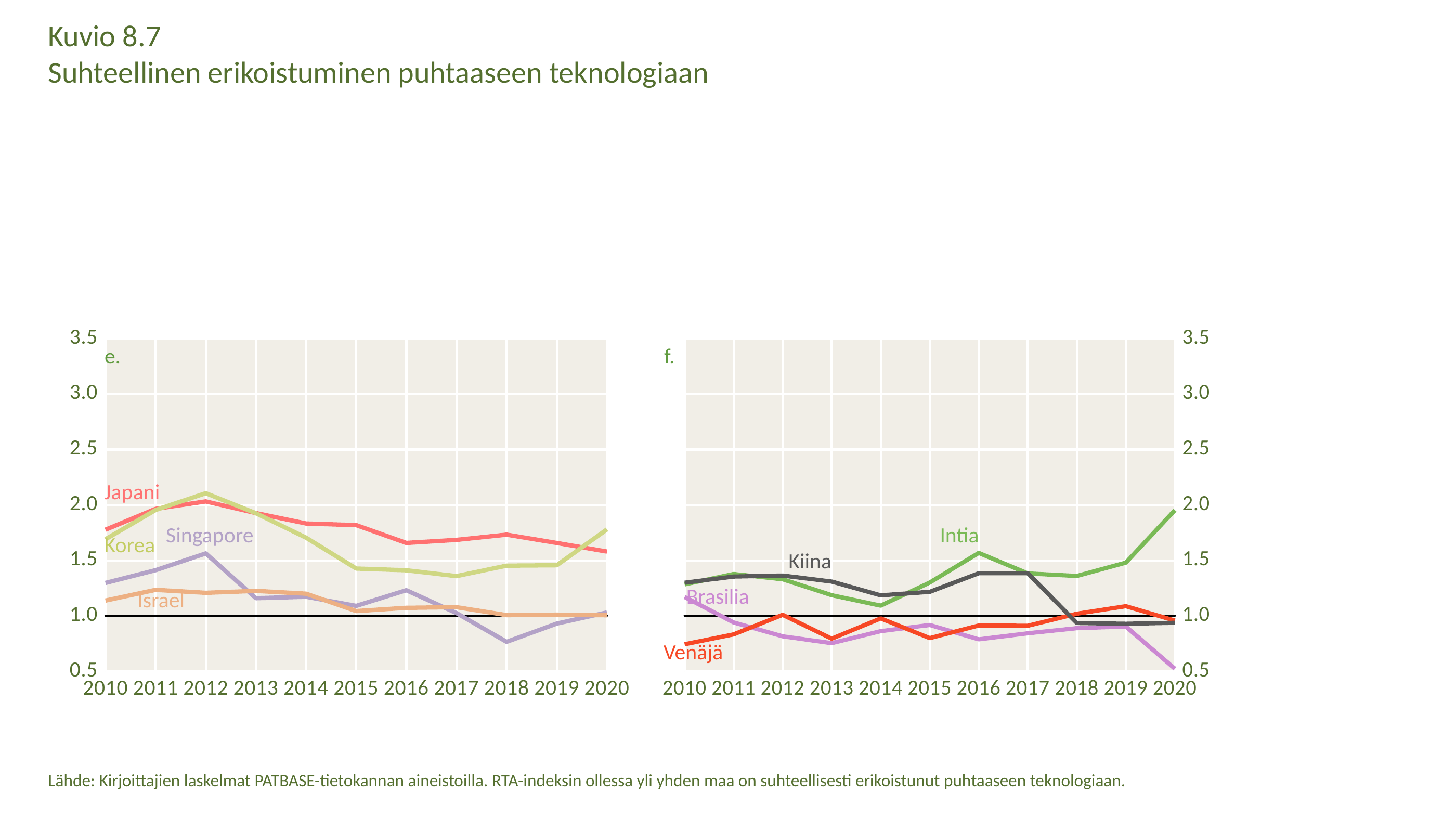
In panel e. on the left, does the value for Singapore rise or fall from 2012 to 2018? fall In panel f. on the right, which country has the lowest value in 2020? Brasilia In panel e. on the left, which country has the highest value in 2016? Japani In panel e. on the left, is the value for Japani in 2010 greater or less than 1.5? greater In panel f. on the right, is the value for Intia in 2020 greater or less than 1.5? greater How many country series are labelled in panel e. on the left? 4 How many country series are labelled in panel f. on the right? 4 What kind of chart is shown in panel e. on the left? line chart In panel e. on the left, is the value for Singapore in 2018 greater or less than 1.0? less How many years are plotted along the x axis of panel f. on the right? 11 In panel f. on the right, which country has the highest value in 2020? Intia